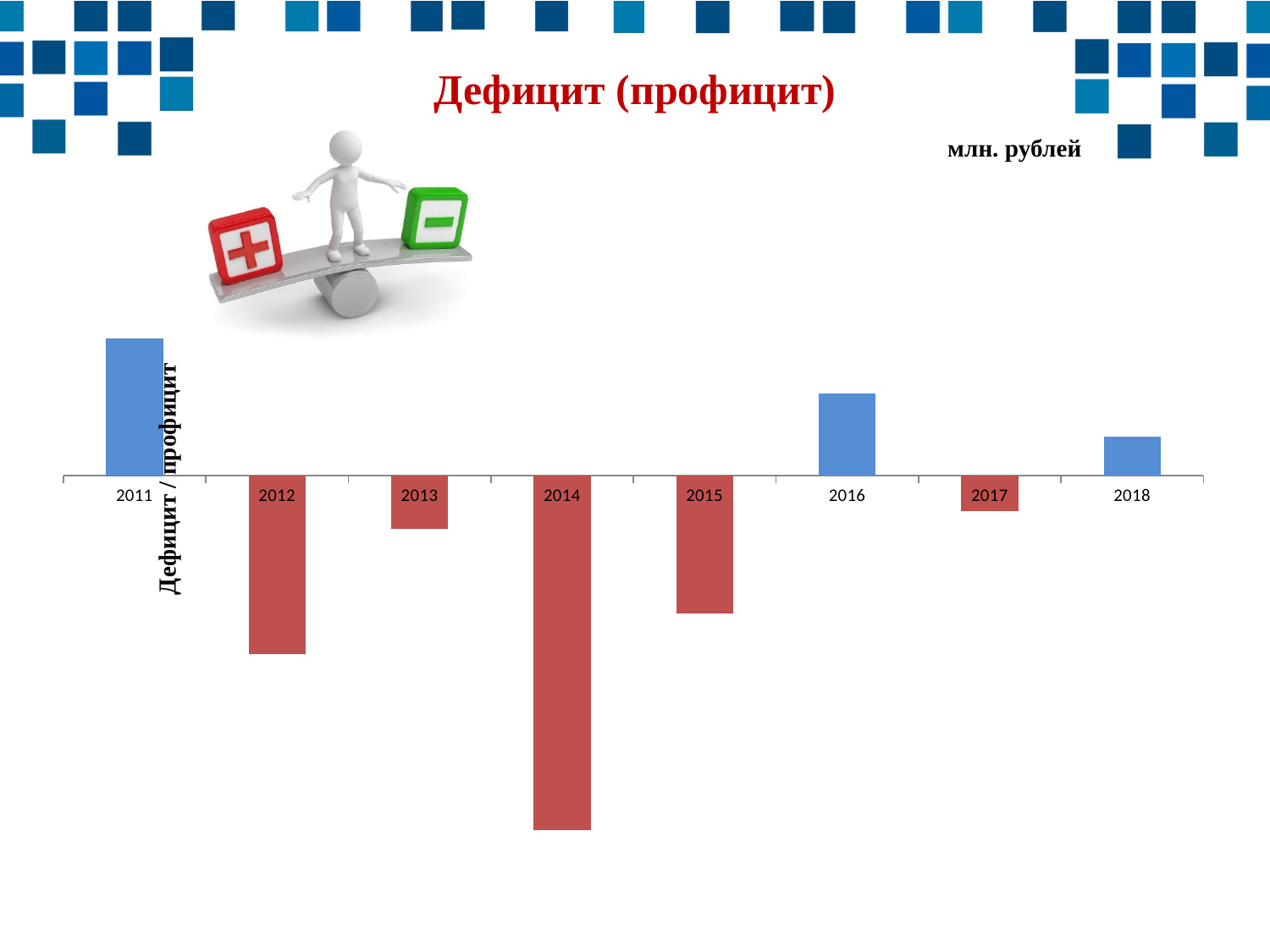
What is the title of the slide? Дефицит (профицит) How many years in the chart show a positive value (bar above the axis)? 3 Which year has the highest value (largest surplus) in the chart? 2011 Which year shows the deeper deficit, 2012 or 2013? 2012 Which year shows the deeper deficit, 2014 or 2015? 2014 In what units are the chart values given, according to the slide? млн. рублей Which year has the larger value, 2016 or 2018? 2016 How many years are shown on the x axis of the chart? 8 How many years in the chart show a negative value (bar below the axis)? 5 Which year has the lowest value (deepest deficit) in the chart? 2014 What kind of chart is shown on the slide? bar chart